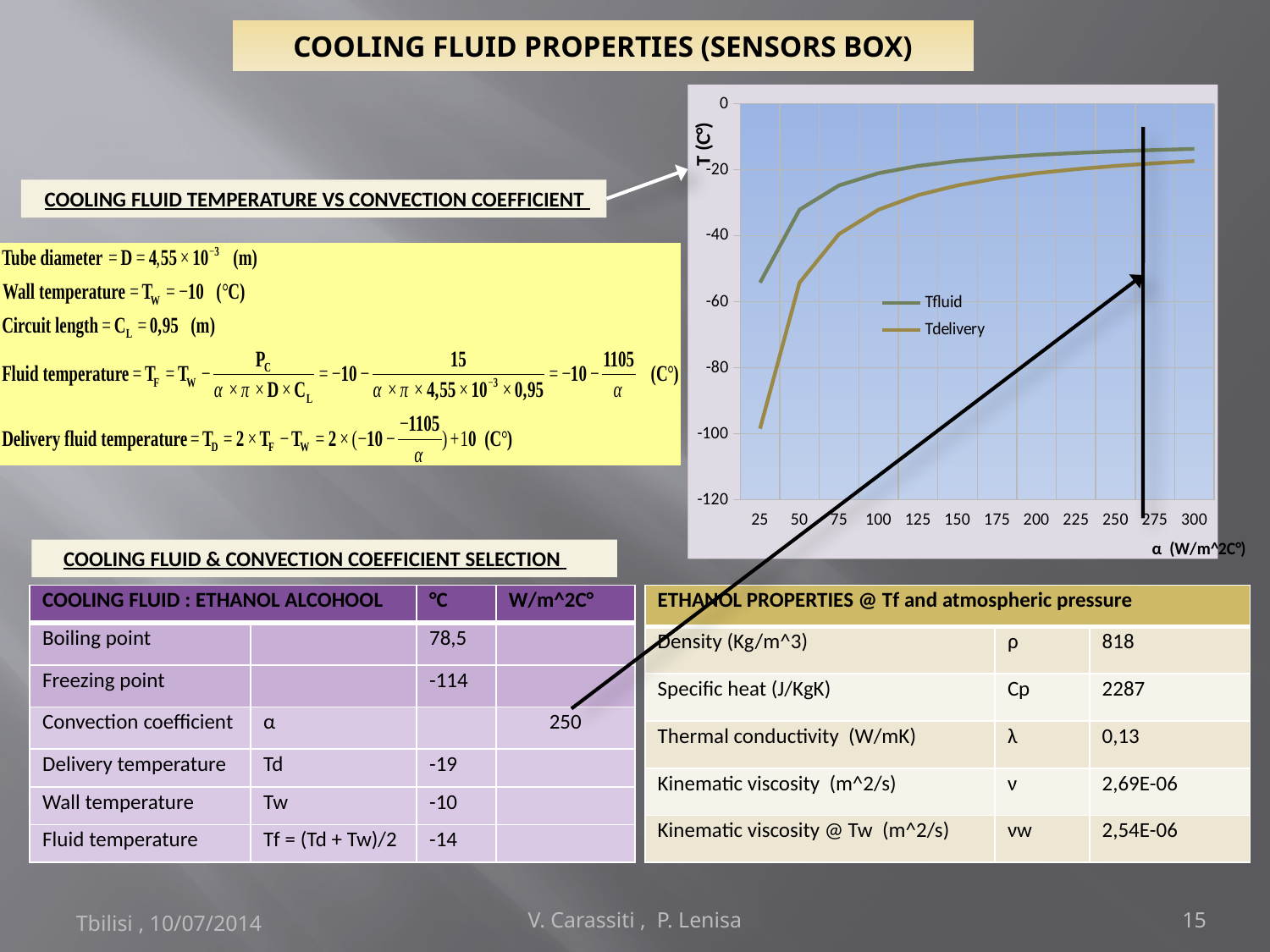
What are the two series named in the chart legend? Tfluid and Tdelivery What is the label of the chart's y axis? T (C°) Do the Tdelivery values rise or fall as α increases along the x axis? rise At α = 25, which series has the higher temperature, Tfluid or Tdelivery? Tfluid Is the Tfluid value at α = 25 greater or less than -40? less At which α value is the Tdelivery series at its lowest? 25 Is the Tdelivery value at α = 25 greater or less than -80? less Do the Tfluid values rise or fall as α increases along the x axis? rise How many α values are marked along the x axis of the chart? 12 Is the Tfluid value at α = 300 greater or less than -20? greater How many series does the chart legend list? 2 What kind of chart is shown on the slide? line chart